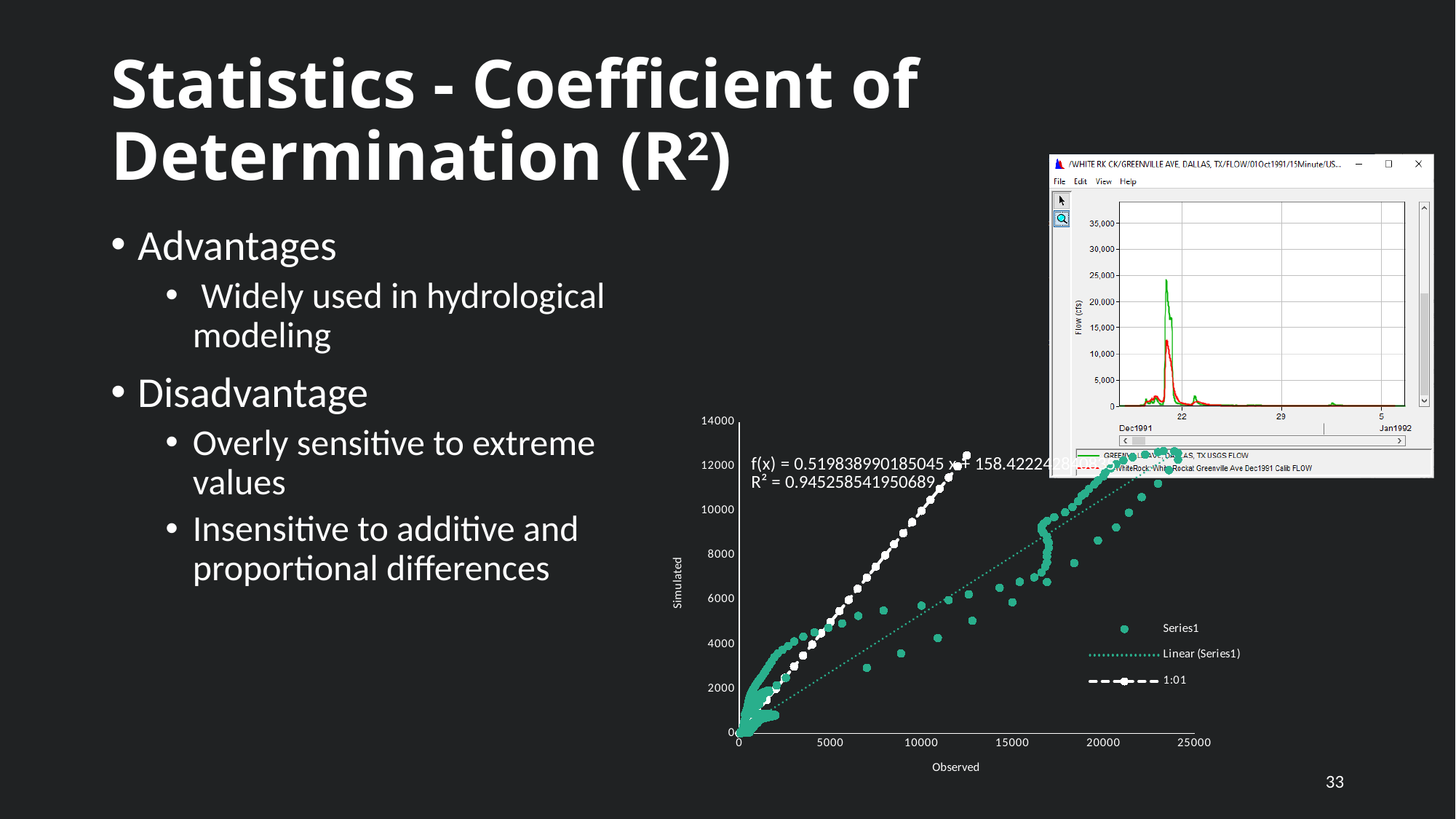
In the embedded flow time-series window at the top right, which line reaches the higher peak, the green line or the red line? green In the embedded flow time-series window at the top right, is the peak of the green line greater or less than 20,000? greater How many entries does the legend of the Observed vs Simulated scatter chart list? 3 What is the label of the x axis of the scatter chart? Observed What kind of chart is the chart with the axes Observed and Simulated? scatter chart On the Observed vs Simulated scatter chart, do the Series1 points generally rise or fall as Observed increases? rise On the Observed vs Simulated scatter chart, what R² value is printed for the linear fit? 0.945258541950689 What is the name of the dashed line series in the legend of the scatter chart? 1:01 On the Observed vs Simulated scatter chart, what is the slope coefficient printed in the fitted equation f(x)? 0.519838990185045 In the embedded flow time-series window at the top right, is the peak of the red line greater or less than 15,000? less What is the highest tick value shown on the x axis (Observed) of the scatter chart? 25000 What is the highest tick value shown on the y axis (Simulated) of the scatter chart? 14000